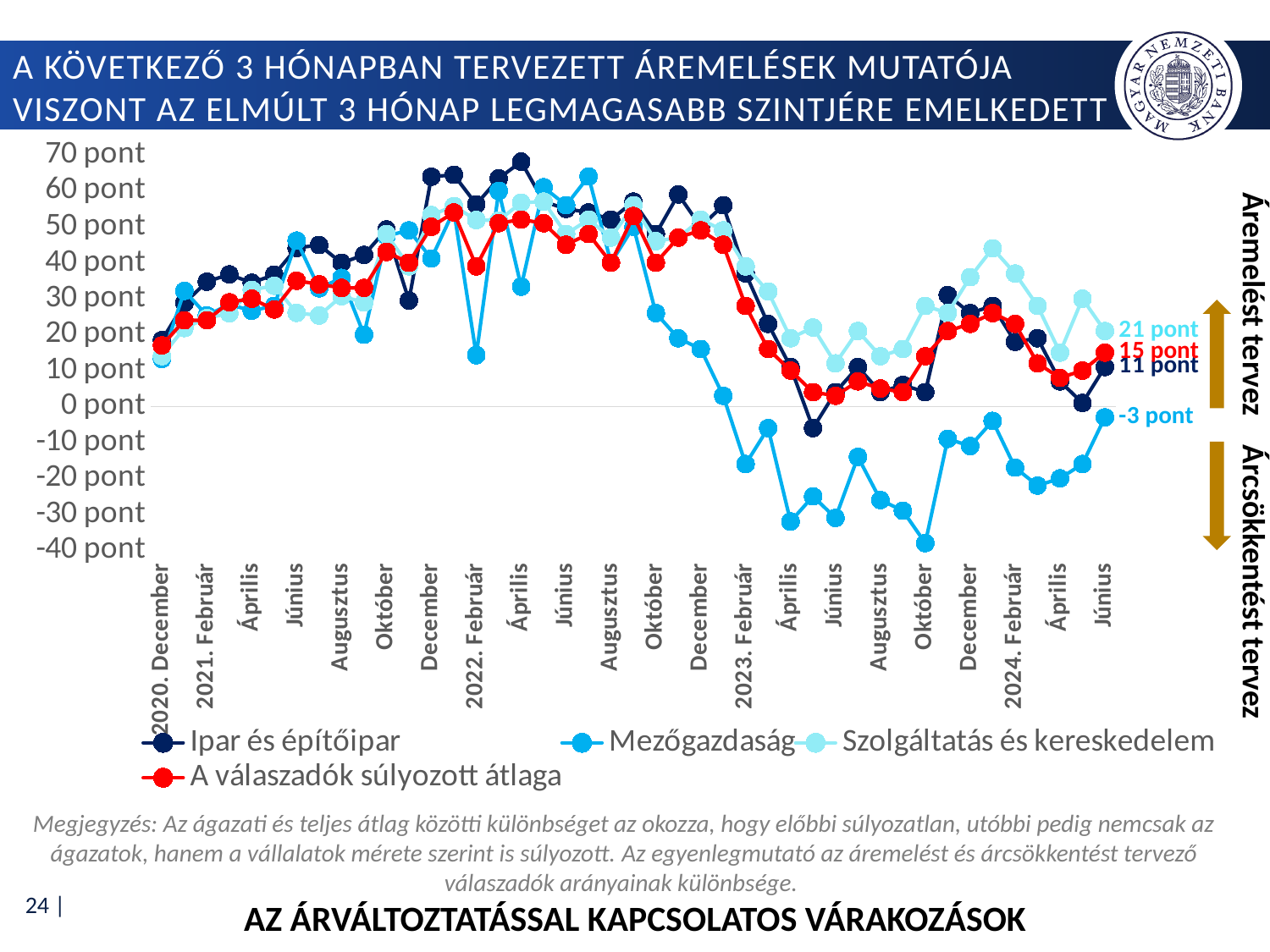
What is the final (2024 Június) value labelled for Szolgáltatás és kereskedelem? 21 pont What is the difference between the final values of A válaszadók súlyozott átlaga and Ipar és építőipar? 4 pont What is the difference between the final values of Szolgáltatás és kereskedelem and Mezőgazdaság? 24 pont What kind of chart is shown on the slide? line chart Is the value for Mezőgazdaság in 2023 Április greater or less than -20 pont? less How many series does the legend list? 4 Which series has the lowest value at the last point (2024 Június)? Mezőgazdaság What is the final (2024 Június) value labelled for Mezőgazdaság? -3 pont Which series has the highest value at the last point (2024 Június)? Szolgáltatás és kereskedelem What is the final (2024 Június) value labelled for A válaszadók súlyozott átlaga? 15 pont What is the final (2024 Június) value labelled for Ipar és építőipar? 11 pont Does the Mezőgazdaság series rise or fall between 2022 Október and 2023 Április? fall